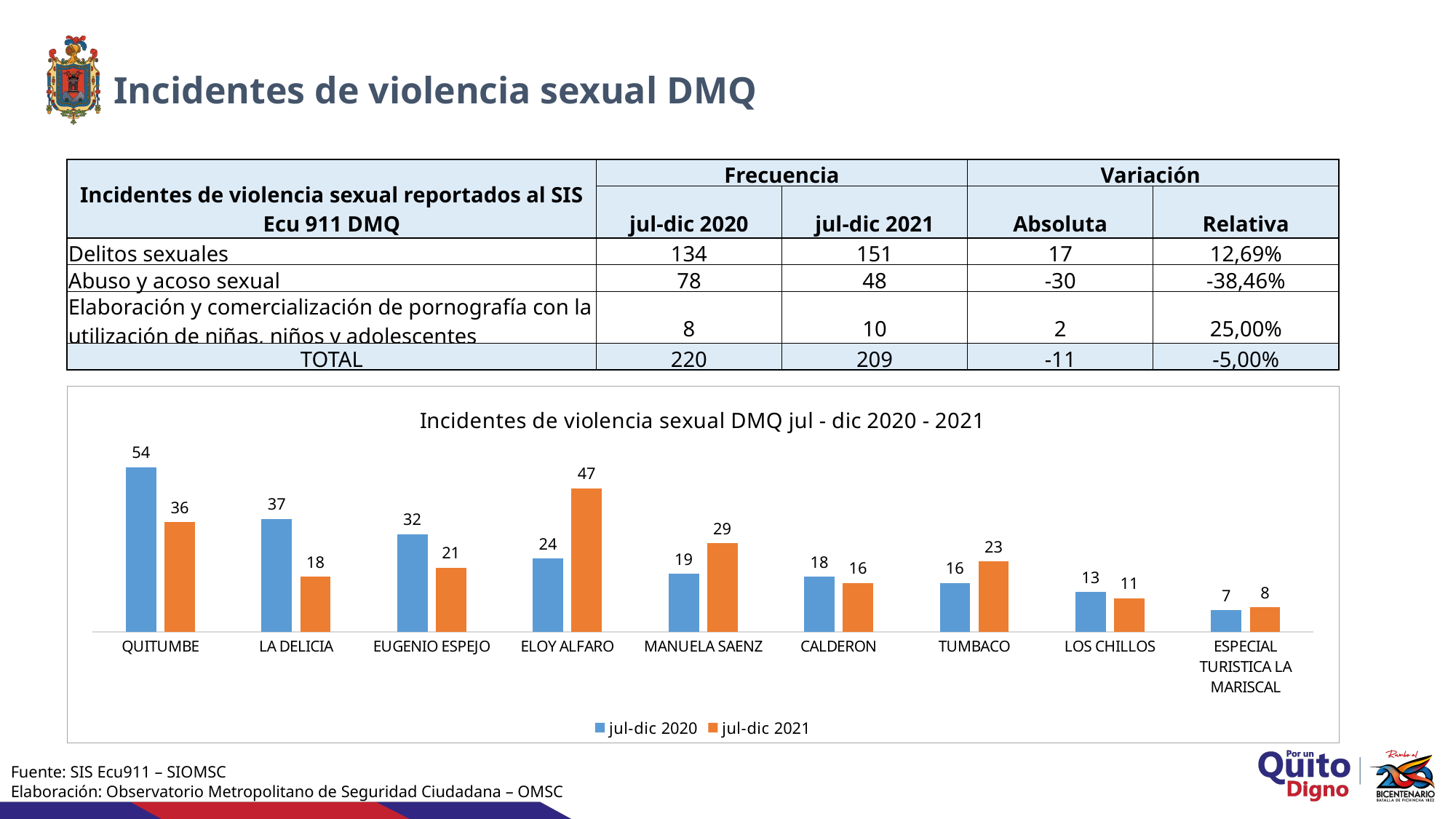
How many categories are shown on the x axis of the chart? 9 What is the value for LOS CHILLOS in the jul-dic 2021 series? 11 Do the jul-dic 2020 values generally rise or fall from left to right along the x axis? fall For MANUELA SAENZ, which series has the larger value, jul-dic 2020 or jul-dic 2021? jul-dic 2021 What is the value for QUITUMBE in the jul-dic 2020 series? 54 How many series does the chart legend list? 2 What is the difference between the jul-dic 2020 and jul-dic 2021 values for LA DELICIA? 19 What is the value for ELOY ALFARO in the jul-dic 2021 series? 47 What kind of chart is shown on the slide? bar chart What is the title of the chart? Incidentes de violencia sexual DMQ jul - dic 2020 - 2021 Which category has the highest value in the jul-dic 2020 series? QUITUMBE Which category has the lowest value in the jul-dic 2021 series? ESPECIAL TURISTICA LA MARISCAL